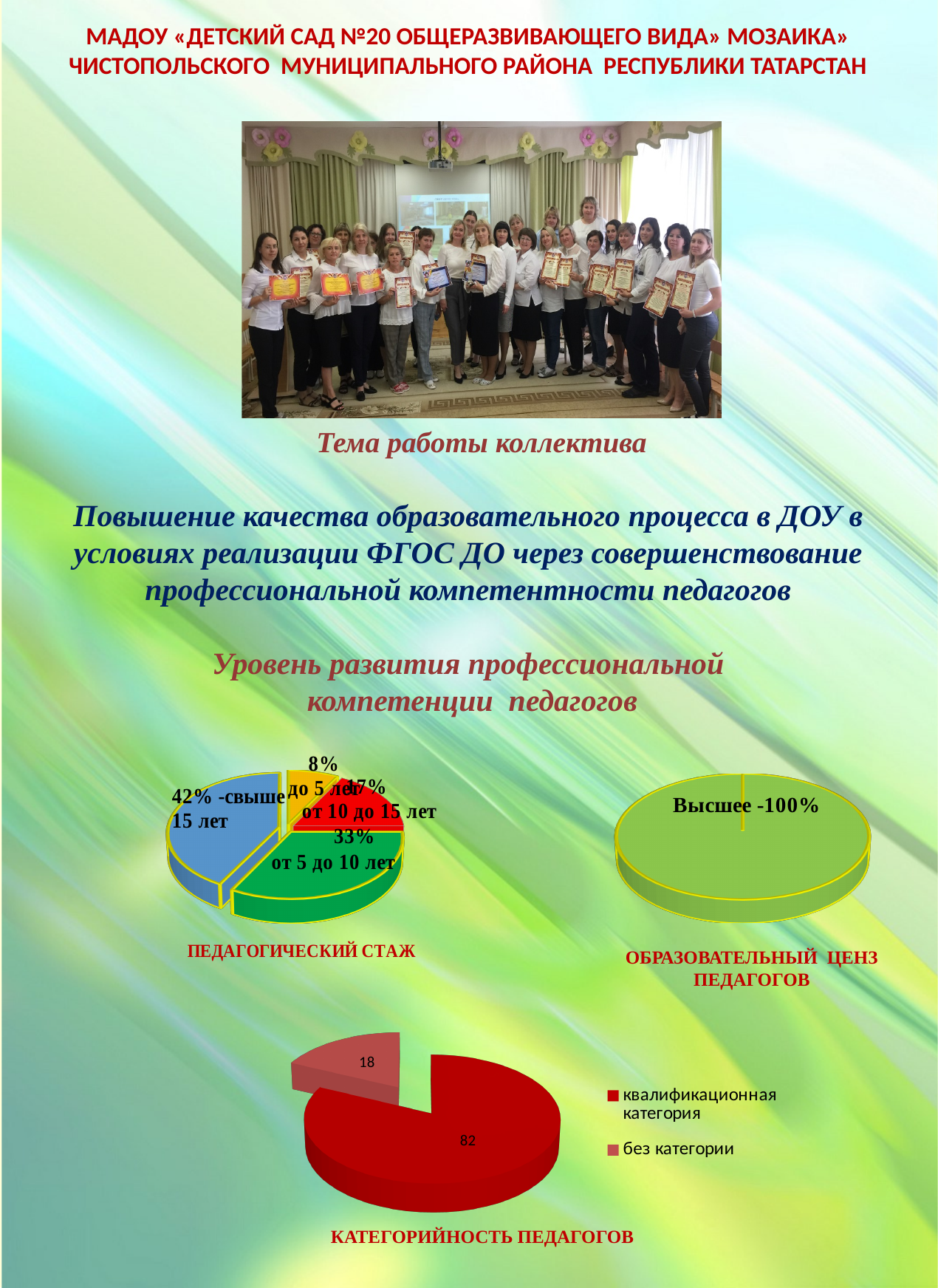
In the 'ПЕДАГОГИЧЕСКИЙ СТАЖ' chart, what share of teachers have from 5 to 10 years of experience? 33% In the 'КАТЕГОРИЙНОСТЬ ПЕДАГОГОВ' chart, how many entries does the legend list? 2 In the 'КАТЕГОРИЙНОСТЬ ПЕДАГОГОВ' chart, what is the value for 'квалификационная категория'? 82 In the 'КАТЕГОРИЙНОСТЬ ПЕДАГОГОВ' chart, which is larger: 'квалификационная категория' or 'без категории'? квалификационная категория In the 'ПЕДАГОГИЧЕСКИЙ СТАЖ' chart, what is the difference in percentage points between the 'от 5 до 10 лет' and 'от 10 до 15 лет' slices? 16 In the 'ПЕДАГОГИЧЕСКИЙ СТАЖ' chart, how many slices does the pie have? 4 In the 'ОБРАЗОВАТЕЛЬНЫЙ ЦЕНЗ ПЕДАГОГОВ' chart, what share of teachers have higher education (Высшее)? 100% In the 'ПЕДАГОГИЧЕСКИЙ СТАЖ' chart, what share of teachers have over 15 years of experience (свыше 15 лет)? 42% In the 'ПЕДАГОГИЧЕСКИЙ СТАЖ' chart, which experience category has the largest share? свыше 15 лет In the 'ПЕДАГОГИЧЕСКИЙ СТАЖ' chart, what share of teachers have up to 5 years of experience (до 5 лет)? 8% What type of chart is 'КАТЕГОРИЙНОСТЬ ПЕДАГОГОВ'? pie chart In the 'ПЕДАГОГИЧЕСКИЙ СТАЖ' chart, which experience category has the smallest share? до 5 лет